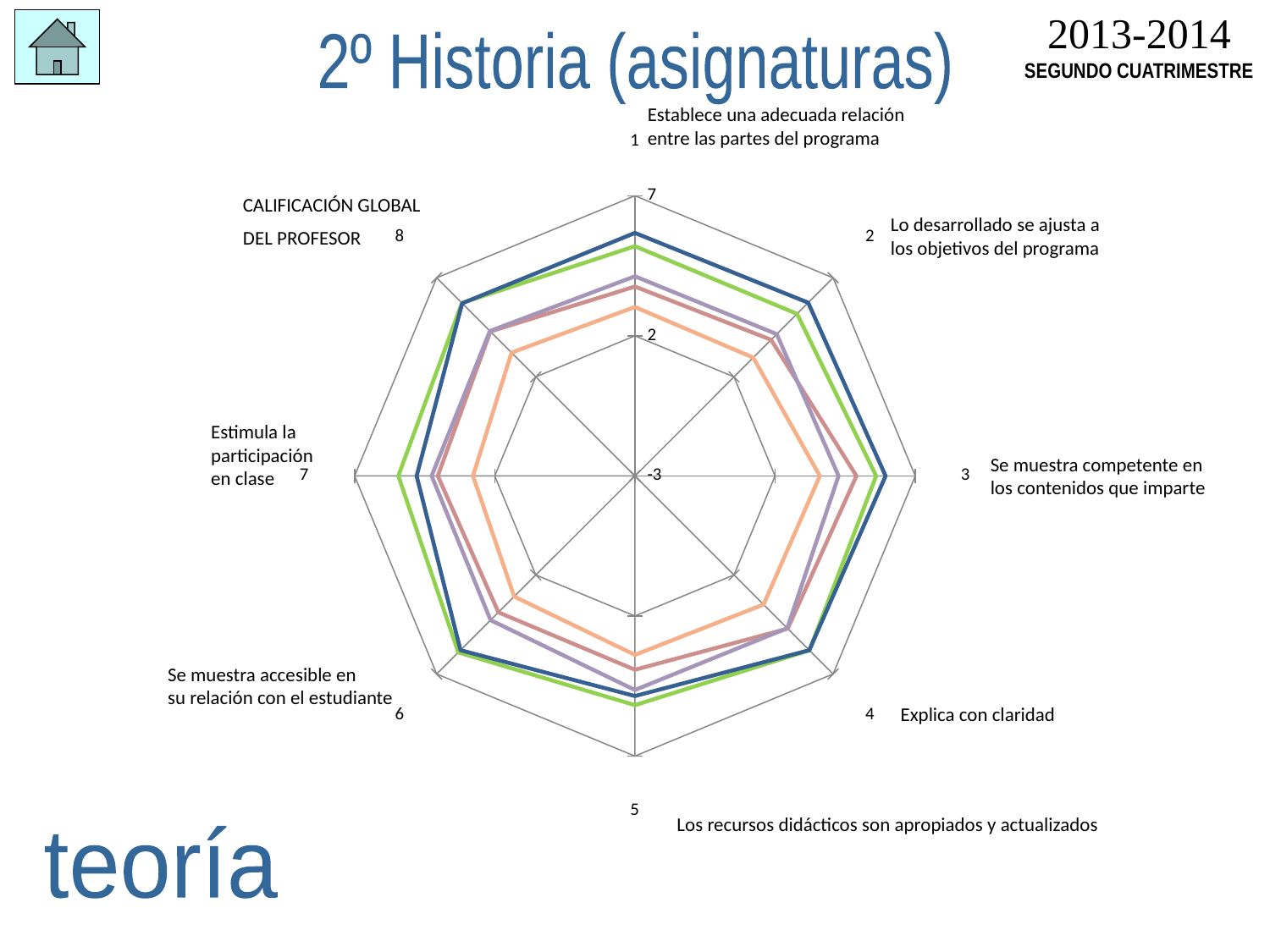
Is the value of the green line for "Los recursos didácticos son apropiados y actualizados" greater or less than 2? greater For "Se muestra competente en los contenidos que imparte", which line has the larger value, the dark blue line or the orange line? dark blue How many data series (lines) are plotted on the radar chart? 5 Is the value of the dark blue line for "Se muestra competente en los contenidos que imparte" greater or less than 2? greater Is the value of the orange line for "Explica con claridad" greater or less than 7? less How many categories (axes) does the radar chart have? 8 What kind of chart is shown on the slide? radar chart For "Estimula la participación en clase", which line has the larger value, the green line or the orange line? green What is the title of the slide containing the radar chart? 2º Historia (asignaturas) What value is shown at the centre of the radar chart's axis? -3